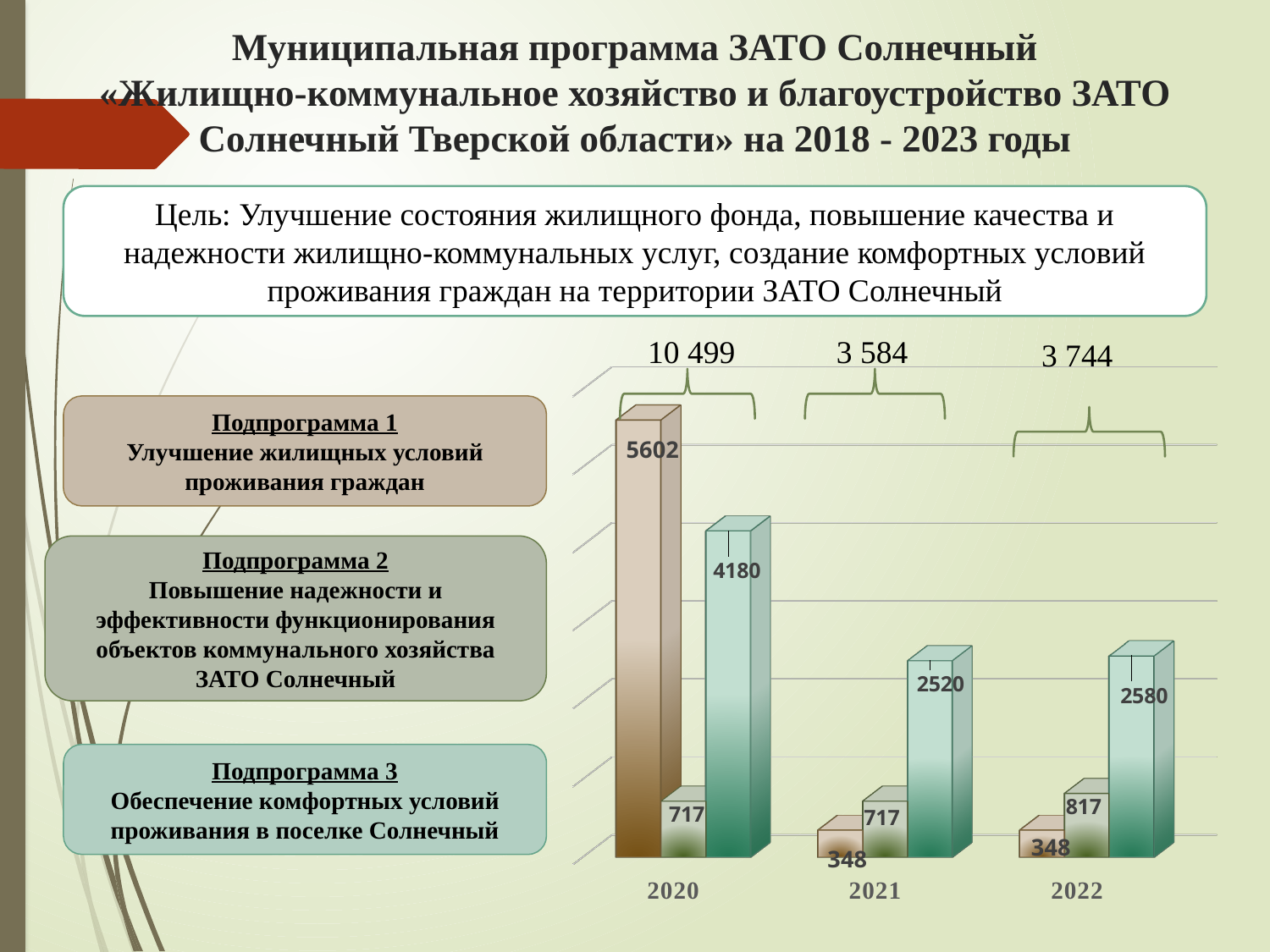
What is the value of the teal (third) bar for 2022? 2580 What is the value of the middle (grey-green) bar for 2022? 817 How many year categories are shown on the x axis? 3 Which year has the highest total printed above its group of bars? 2020 By how much does the teal bar for 2022 exceed the teal bar for 2021? 60 Which is larger: the middle bar for 2021 or the middle bar for 2022? 2022 What total is printed above the 2021 group of bars? 3 584 What kind of chart is shown on the slide? bar chart What is the value of the brown (first) bar for 2021? 348 What is the value of the tallest bar in the 2020 group? 5602 What is the difference between the two tallest bars in 2020 (5602 and 4180)? 1422 What is the value of the teal (third) bar for 2021? 2520